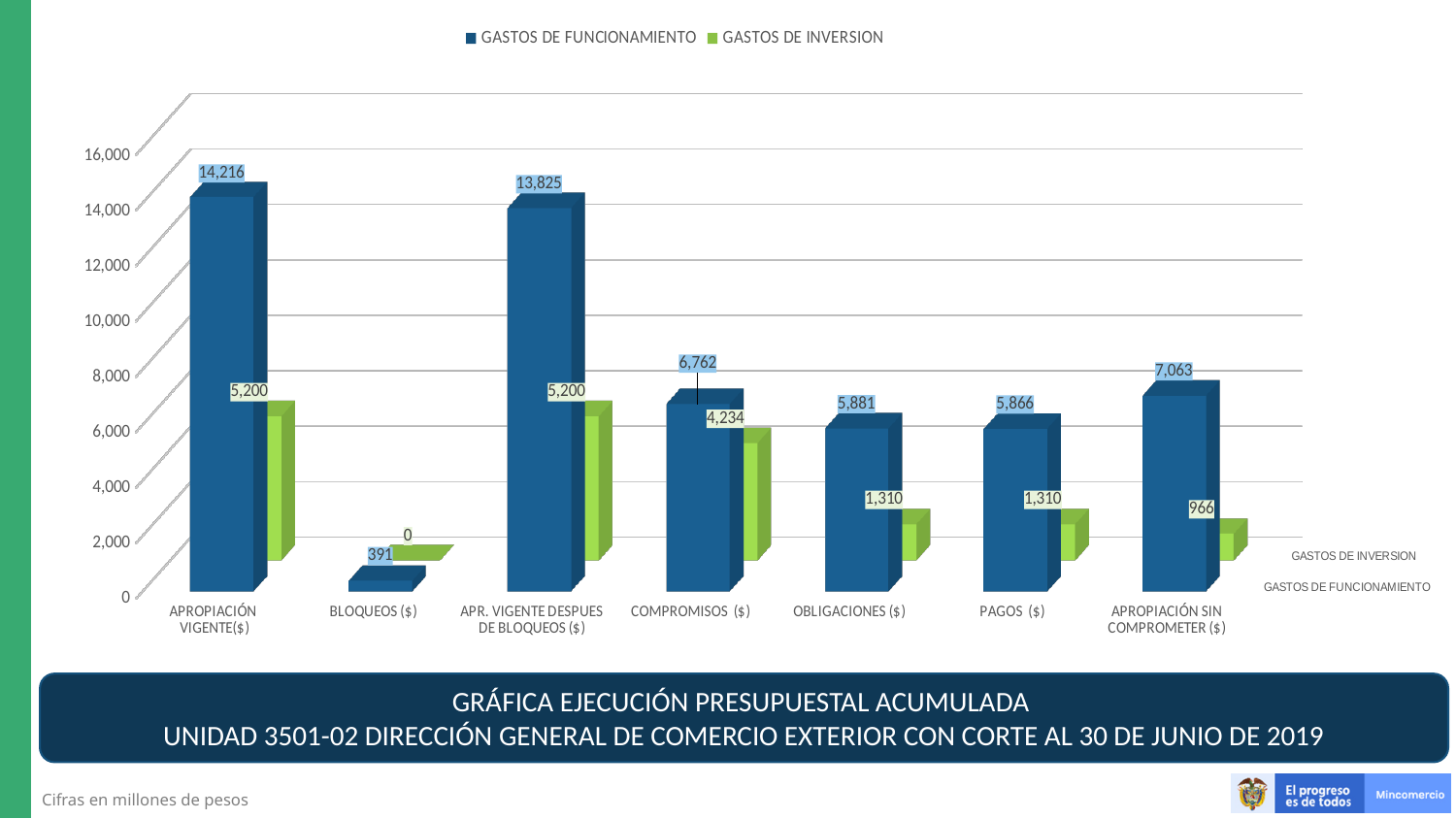
What is the difference between GASTOS DE FUNCIONAMIENTO for APROPIACIÓN VIGENTE($) and for APR. VIGENTE DESPUES DE BLOQUEOS ($)? 391 What is the value of GASTOS DE INVERSION for COMPROMISOS ($)? 4,234 Which category has the highest GASTOS DE FUNCIONAMIENTO value? APROPIACIÓN VIGENTE($) What kind of chart is shown on the slide? Bar chart What is the difference between GASTOS DE FUNCIONAMIENTO and GASTOS DE INVERSION for OBLIGACIONES ($)? 4,571 How many series does the legend list? 2 How many categories are shown on the x axis? 7 Which category has the lowest GASTOS DE INVERSION value? BLOQUEOS ($) What is the value of GASTOS DE INVERSION for APROPIACIÓN SIN COMPROMETER ($)? 966 What is the value of GASTOS DE FUNCIONAMIENTO for APROPIACIÓN VIGENTE($)? 14,216 Which is larger: GASTOS DE FUNCIONAMIENTO for COMPROMISOS ($) or for APROPIACIÓN SIN COMPROMETER ($)? APROPIACIÓN SIN COMPROMETER ($) What is the value of GASTOS DE FUNCIONAMIENTO for BLOQUEOS ($)? 391